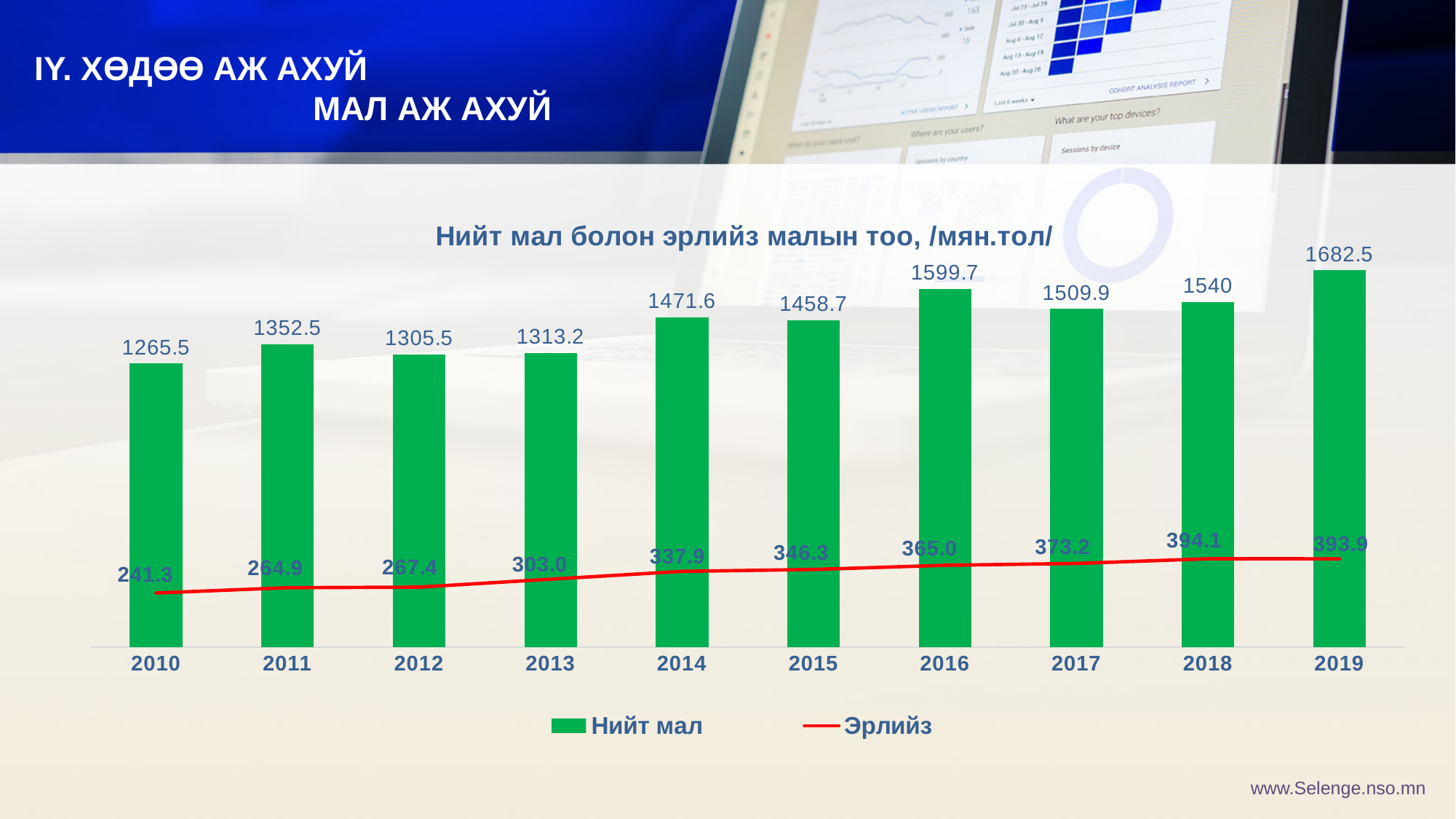
How many years are shown on the x axis? 10 Which is larger, the Нийт мал value for 2016 or for 2017? 2016 Which year has the highest value of Нийт мал? 2019 What is the difference between the Нийт мал values for 2019 and 2010? 417.0 Which year has the lowest value of Эрлийз? 2010 What is the value of Нийт мал for 2018? 1540 Which year has the lowest value of Нийт мал? 2010 What kind of chart is shown on the slide? Bar chart with a line Does the Эрлийз line generally rise or fall from 2010 to 2019? Rise How many series does the legend list? 2 What is the value of Нийт мал for 2019? 1682.5 What is the value of Эрлийз for 2013? 303.0